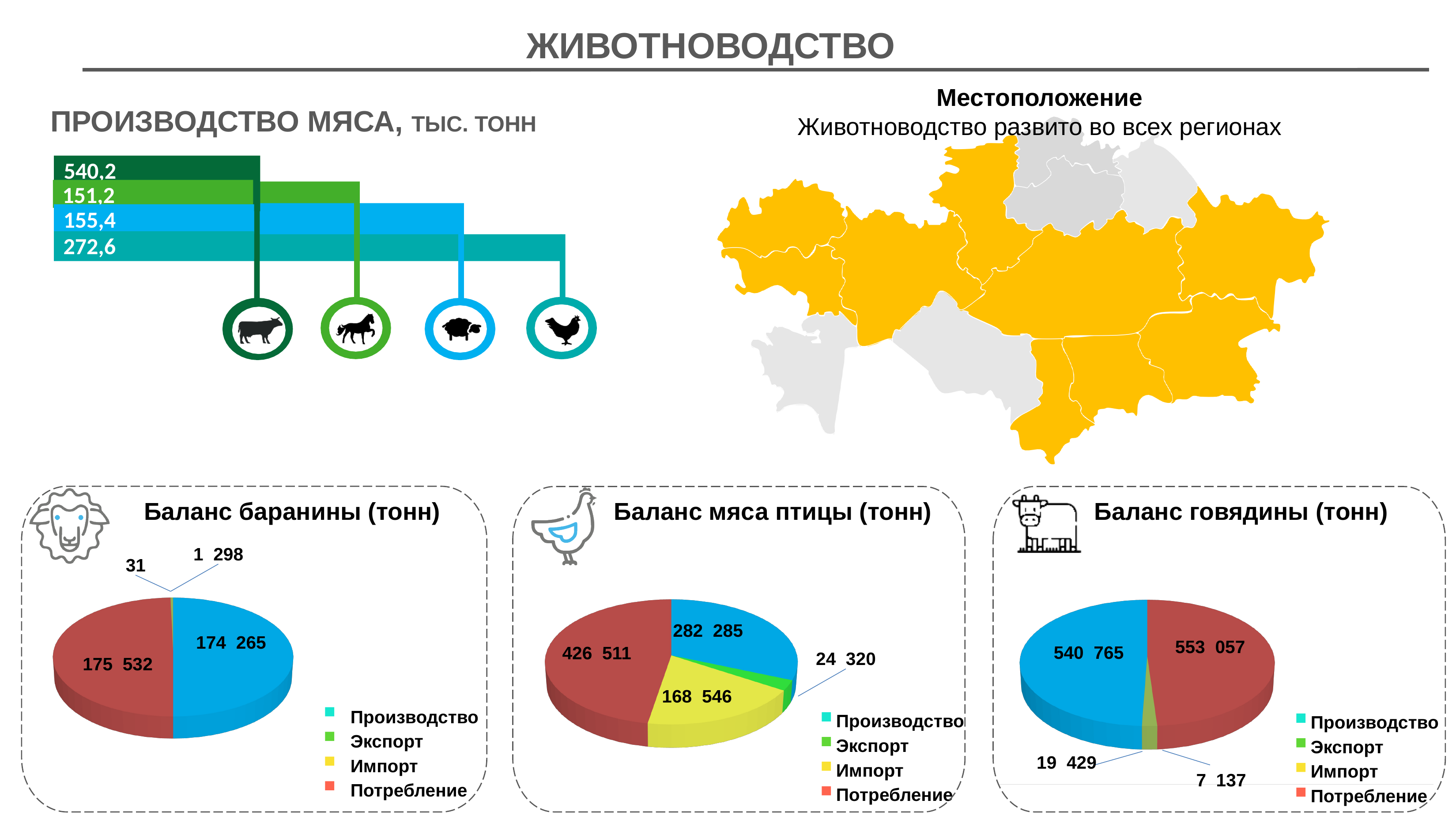
In the "Баланс говядины (тонн)" chart, which is larger, Экспорт or Импорт? Импорт How many entries does the legend of the "Баланс говядины (тонн)" chart list? 4 What kind of chart is the "Баланс баранины (тонн)" chart? pie chart In the "Баланс говядины (тонн)" chart, what is the value for Производство? 540 765 What is the title of the pie chart on the right of the slide? Баланс говядины (тонн) In the "Баланс мяса птицы (тонн)" chart, which category has the largest value? Потребление In the "Баланс говядины (тонн)" chart, what is the value for Импорт? 19 429 In the "Баланс мяса птицы (тонн)" chart, what is the value for Импорт? 168 546 In the "Баланс мяса птицы (тонн)" chart, what is the difference between Потребление and Производство? 144 226 In the "Баланс баранины (тонн)" chart, what is the value for Производство? 174 265